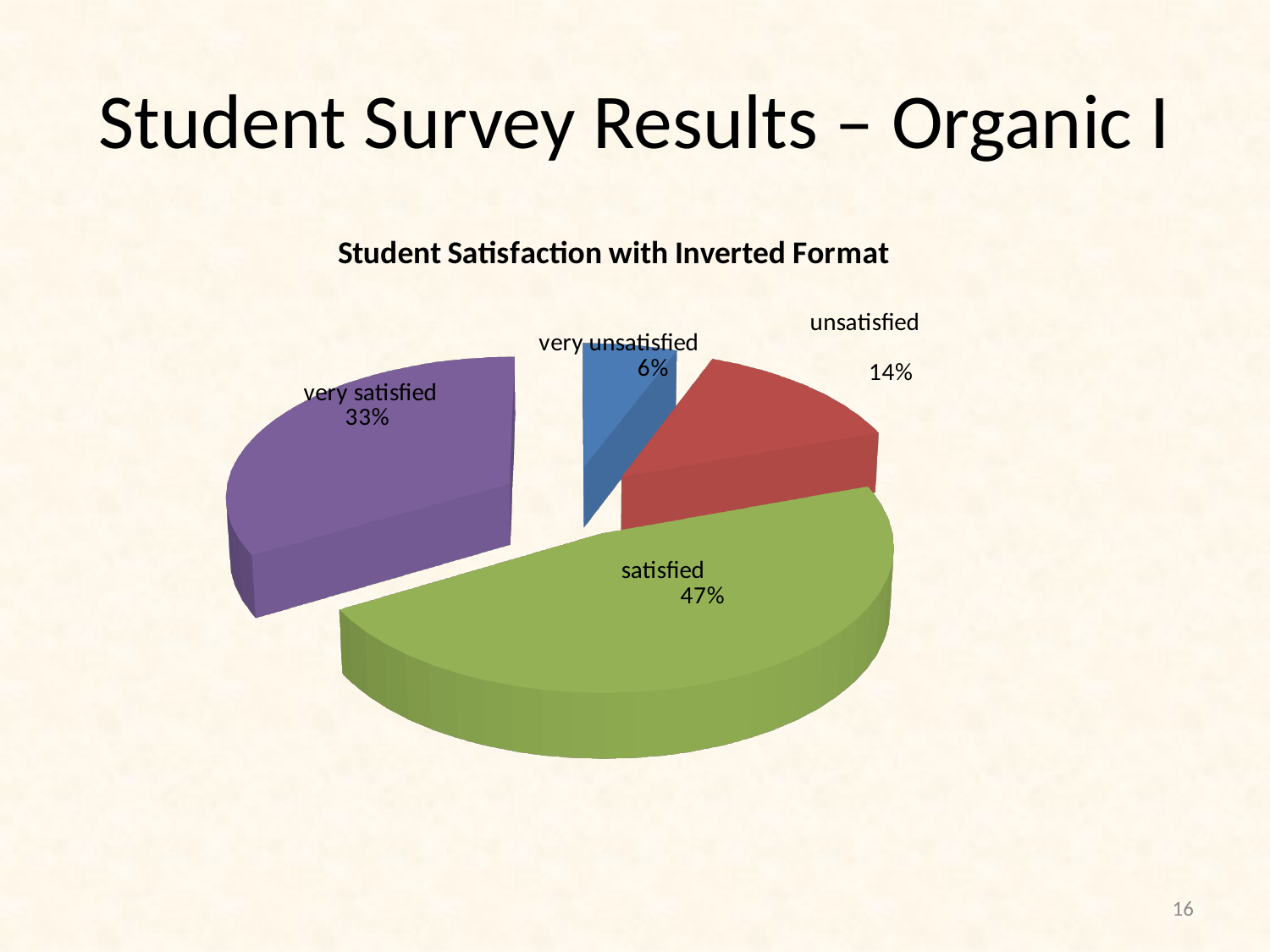
What percentage of students were very satisfied? 33% Which is larger, the unsatisfied share or the very unsatisfied share? unsatisfied What percentage of students were unsatisfied? 14% What is the title of the chart? Student Satisfaction with Inverted Format Which category has the largest share of the pie? satisfied What percentage of students were very unsatisfied? 6% What type of chart is shown on the slide? Pie chart What percentage of students were satisfied? 47% What is the difference between the satisfied and very satisfied percentages? 14% Which category has the smallest share of the pie? very unsatisfied What colour is the slice for satisfied? Green How many categories are shown in the pie chart? 4